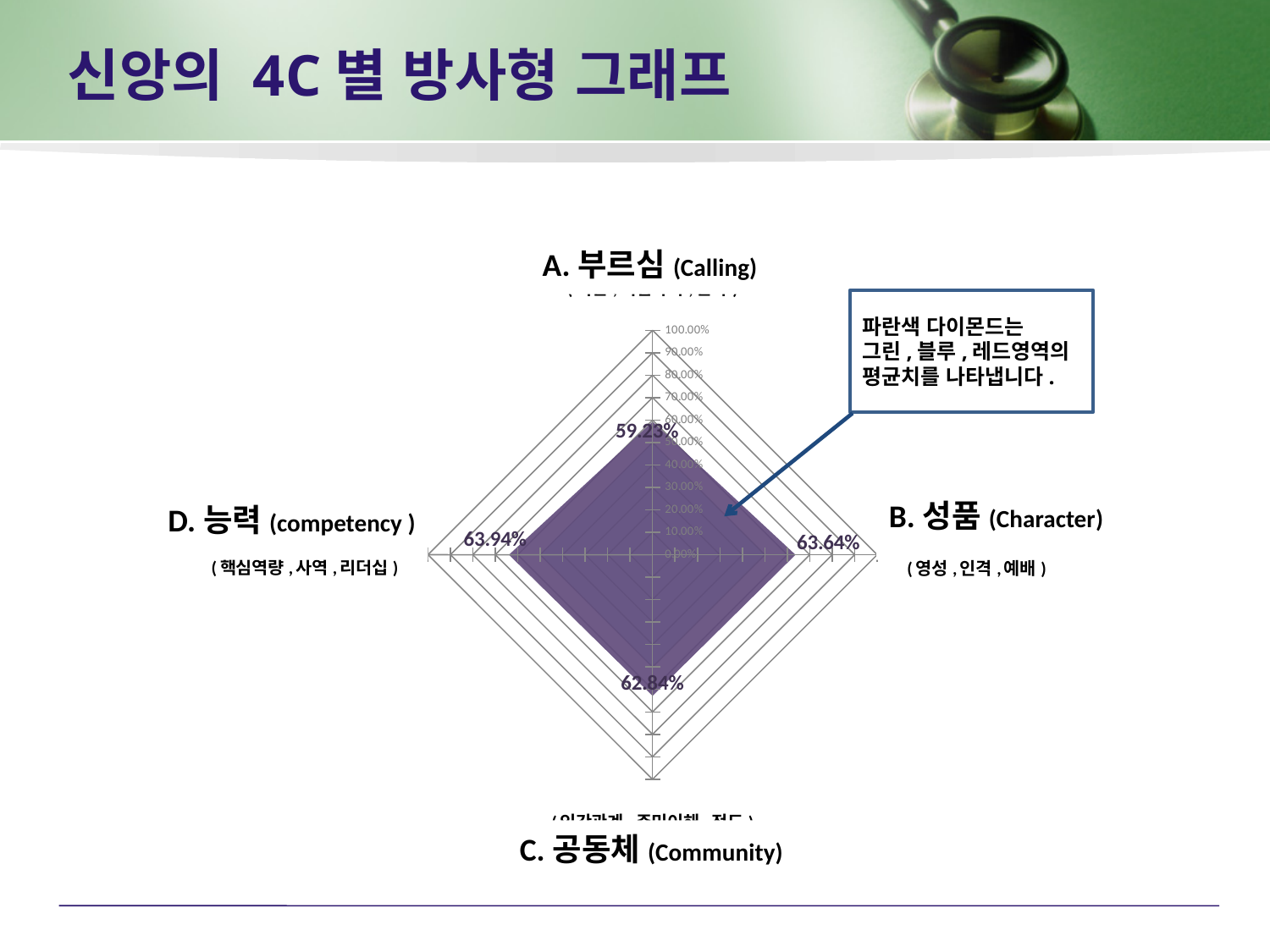
What is the value for B. 성품 (Character) on the radar chart? 63.64% What kind of chart is shown on the slide? Radar chart What is the difference between the values for D. 능력 (competency) and A. 부르심 (Calling)? 4.71% Which of the four categories has the highest value? D. 능력 (competency) What is the value for A. 부르심 (Calling) on the radar chart? 59.23% What is the value for D. 능력 (competency) on the radar chart? 63.94% What is the difference between the values for B. 성품 (Character) and C. 공동체 (Community)? 0.80% What is the value for C. 공동체 (Community) on the radar chart? 62.84% Which is larger, the value for B. 성품 (Character) or the value for C. 공동체 (Community)? B. 성품 (Character) Is the value for A. 부르심 (Calling) greater or less than 60.00%? less How many categories (axes) does the radar chart have? 4 Which of the four categories has the lowest value? A. 부르심 (Calling)